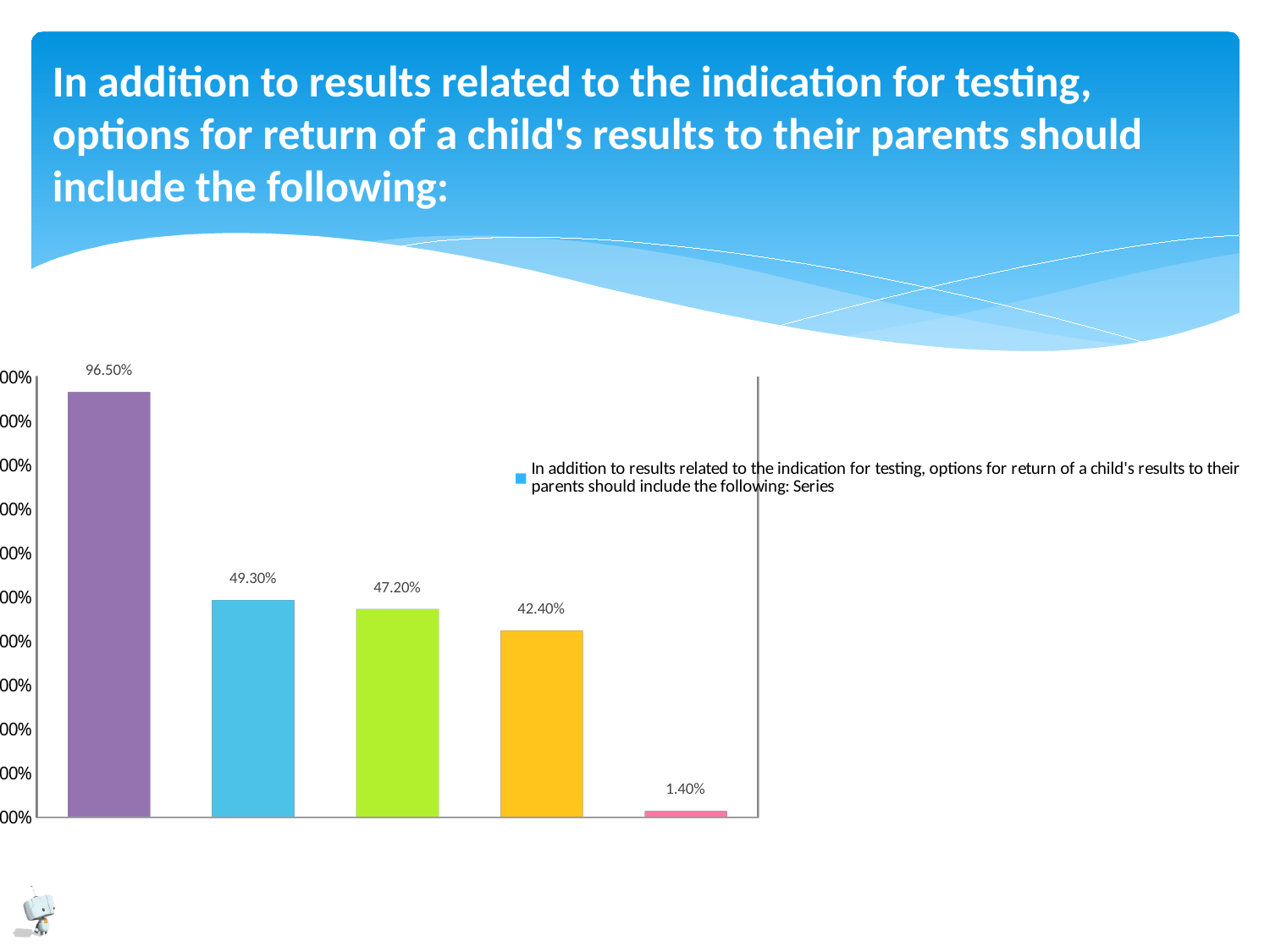
Which is larger, the green bar or the yellow bar? The green bar How many bars are plotted in the chart? 5 What is the value shown on the green bar? 47.20% What is the value shown on the second bar from the left (blue)? 49.30% What is the value shown on the yellow bar? 42.40% How many series does the legend list? 1 What is the value shown on the rightmost (pink) bar? 1.40% What is the difference between the leftmost bar (96.50%) and the second bar (49.30%)? 47.20% What kind of chart is shown on the slide? Bar chart Which bar has the highest value? The leftmost (purple) bar, 96.50% Which bar has the lowest value? The rightmost (pink) bar, 1.40% What is the value shown on the leftmost (purple) bar? 96.50%